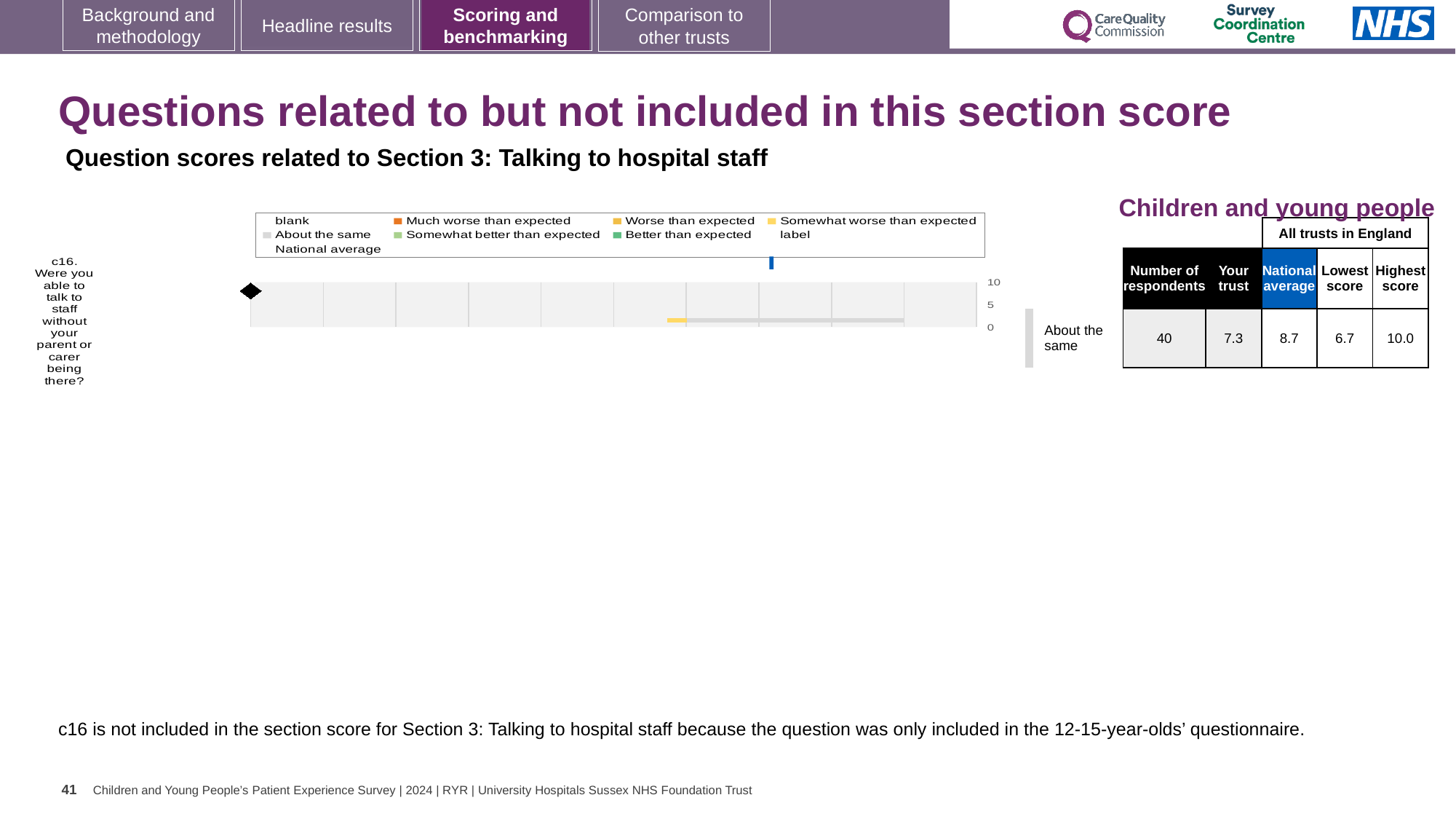
What is the national average score for c16? 8.7 How many survey questions are plotted on the chart? 1 What comparison category is shown for c16 next to the chart? About the same What is the highest score among all trusts in England for c16? 10.0 Which is larger for c16, the 'Your trust' score or the national average? National average How many respondents answered c16? 40 What is the lowest score among all trusts in England for c16? 6.7 What is the difference between the highest score and the lowest score for c16? 3.3 Which question is plotted on the chart? c16. Were you able to talk to staff without your parent or carer being there? What is the 'Your trust' score for c16? 7.3 What kind of chart is used to show the c16 question score? bar chart What is the maximum value shown on the chart's score axis? 10